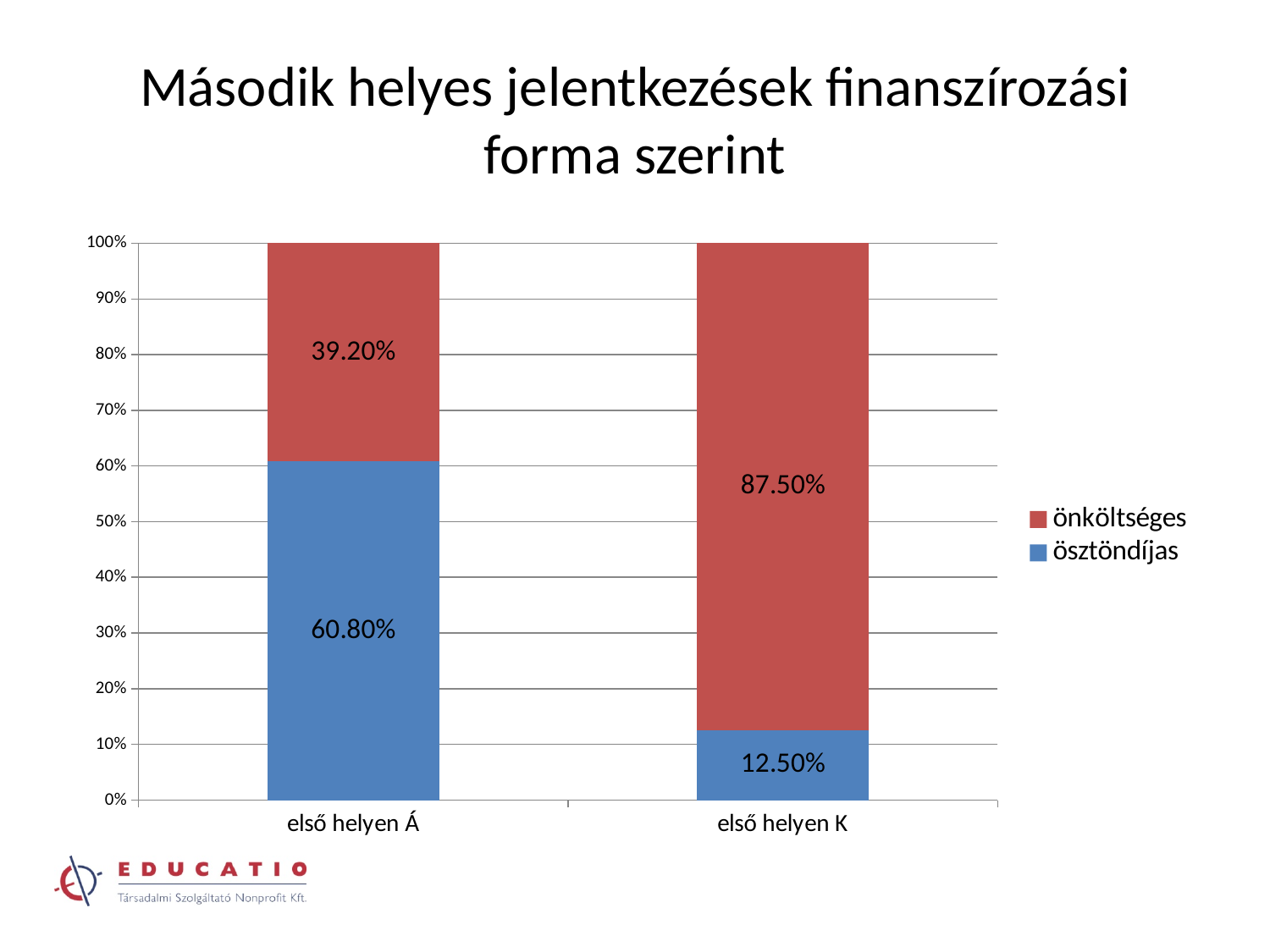
What is the value for ösztöndíjas in the első helyen Á bar? 60.80% What is the value for önköltséges in the első helyen K bar? 87.50% What is the title of the chart? Második helyes jelentkezések finanszírozási forma szerint What is the difference between the ösztöndíjas values for első helyen Á and első helyen K? 48.30% What kind of chart is shown on the slide? stacked bar chart Which category has the lower önköltséges share? első helyen Á Which category has the higher ösztöndíjas share? első helyen Á What is the value for ösztöndíjas in the első helyen K bar? 12.50% How many categories are shown on the x axis? 2 What is the value for önköltséges in the első helyen Á bar? 39.20% How many series does the legend list? 2 Is the önköltséges value for első helyen K larger or smaller than the önköltséges value for első helyen Á? larger